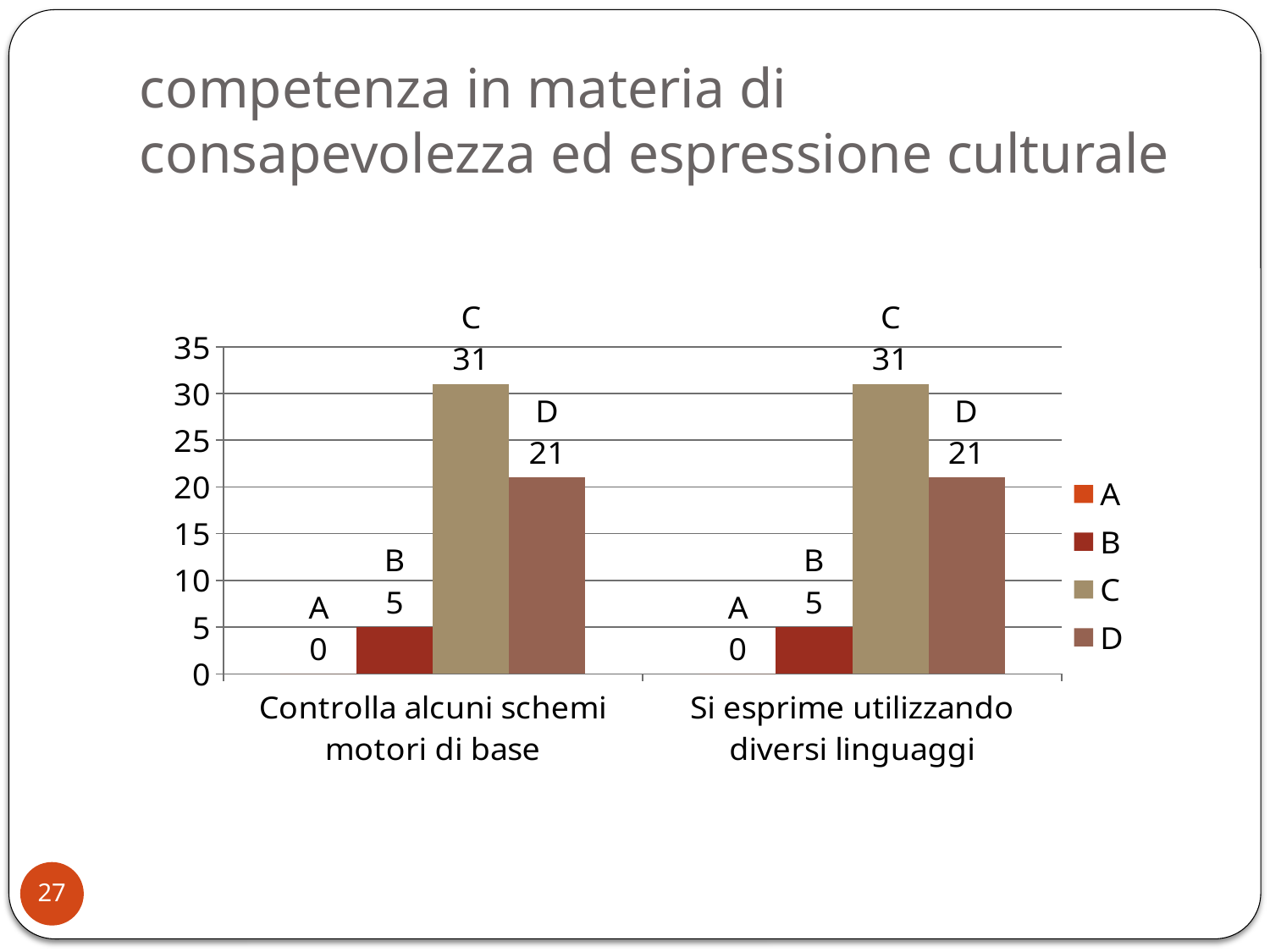
What is the total of the values for series A, B, C and D in the category "Controlla alcuni schemi motori di base"? 57 What is the value for series D in the category "Si esprime utilizzando diversi linguaggi"? 21 What is the value for series C in the category "Controlla alcuni schemi motori di base"? 31 What is the difference between the values for series C and series D in the category "Controlla alcuni schemi motori di base"? 10 Which series has the lowest value in the category "Controlla alcuni schemi motori di base"? A In the category "Si esprime utilizzando diversi linguaggi", which is larger: the value for series B or the value for series D? D What kind of chart is shown on the slide? bar chart Which series has the highest value in the category "Si esprime utilizzando diversi linguaggi"? C How many series does the legend list? 4 How many categories are shown on the x axis? 2 What is the value for series A in the category "Si esprime utilizzando diversi linguaggi"? 0 What is the value for series B in the category "Controlla alcuni schemi motori di base"? 5